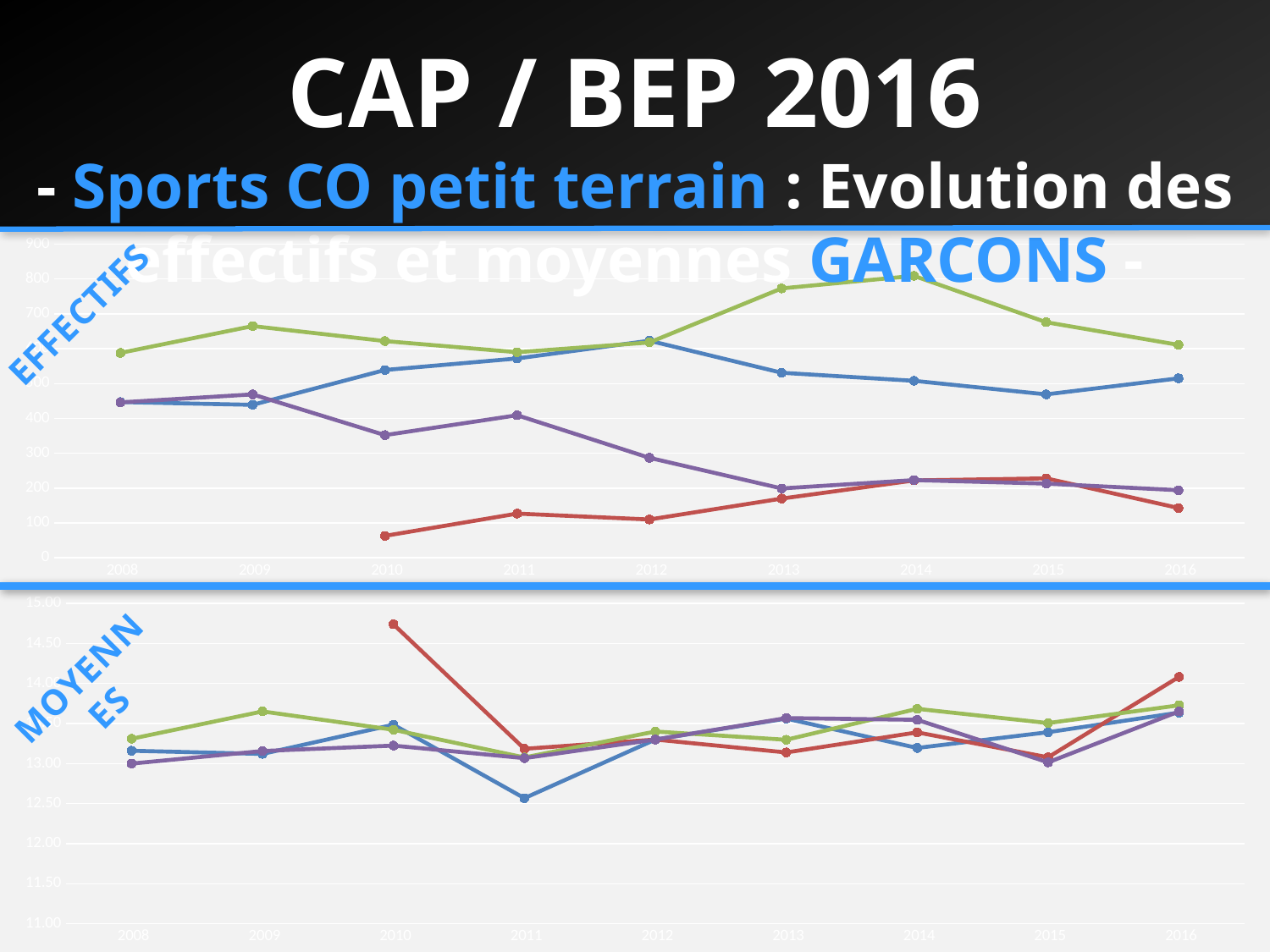
What is the highest value shown on the y axis of the bottom chart (MOYENNES)? 15.00 On the top chart (EFFECTIFS), is the value of the green line in 2014 greater or less than 700? greater On the bottom chart (MOYENNES), which line has the lowest value in 2011? the blue line How many lines are plotted on the top chart (EFFECTIFS)? 4 On the top chart (EFFECTIFS), is the value of the red line in 2010 greater or less than 100? less On the top chart (EFFECTIFS), does the purple line rise or fall overall from 2008 to 2016? fall On the top chart (EFFECTIFS), in 2013 which is higher, the green line or the blue line? the green line What kind of chart is the top chart (EFFECTIFS)? line chart On the top chart (EFFECTIFS), which line has the lowest value in 2010? the red line On the top chart (EFFECTIFS), in which year does the green line reach its highest value? 2014 How many years are shown on the x axis of the bottom chart (MOYENNES)? 9 On the bottom chart (MOYENNES), is the value of the red line in 2010 greater or less than 14.50? greater